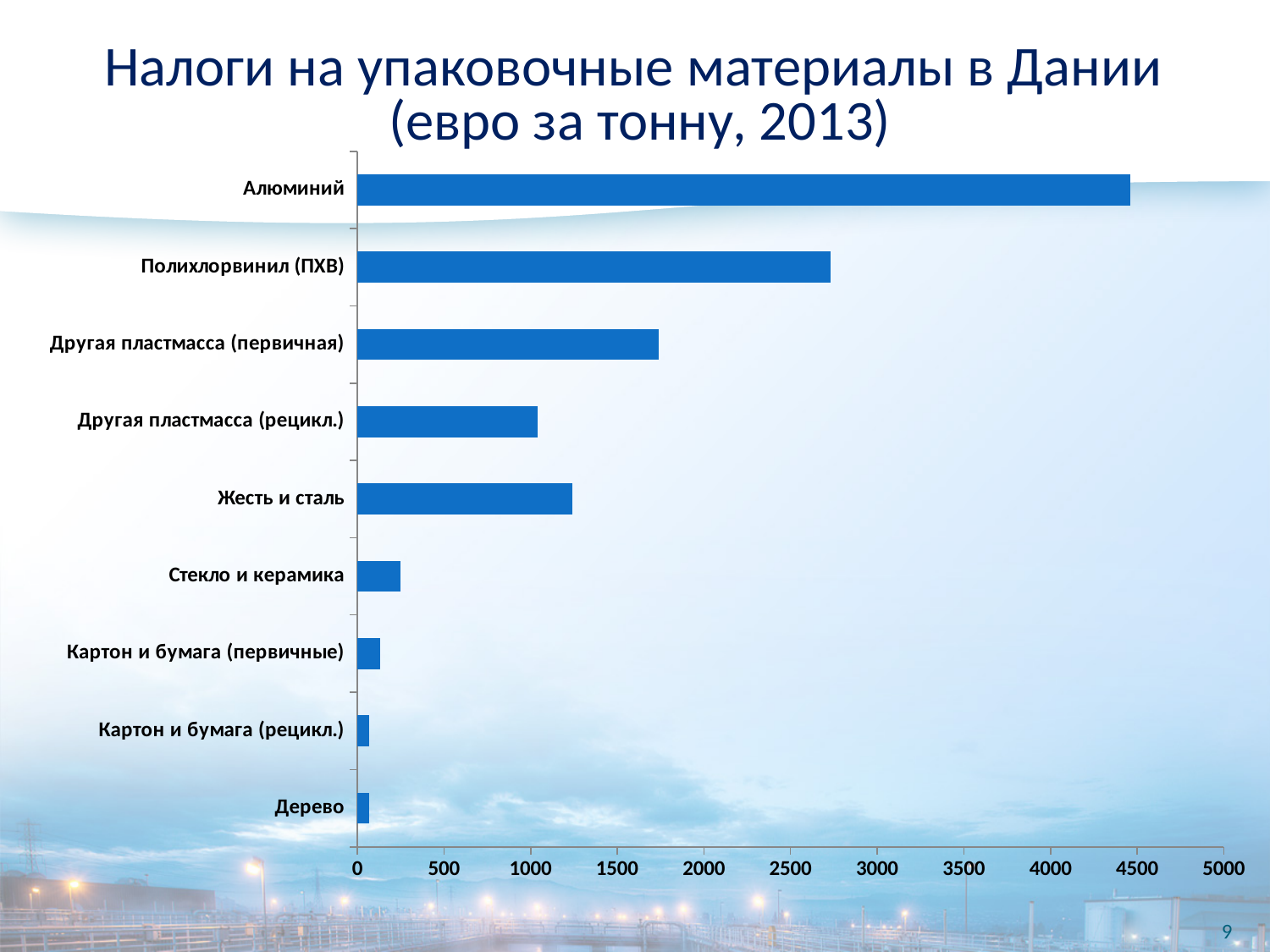
Which packaging material has the highest tax in the chart? Алюминий What kind of chart is shown on the slide? bar chart Is the value for Жесть и сталь greater or less than 1000? greater Which has a higher value: Жесть и сталь or Другая пластмасса (рецикл.)? Жесть и сталь Which has a higher value: Полихлорвинил (ПХВ) or Другая пластмасса (первичная)? Полихлорвинил (ПХВ) Is the value for Другая пластмасса (первичная) greater or less than 1500? greater Is the value for Картон и бумага (первичные) greater or less than 500? less What is the maximum value shown on the horizontal axis of the chart? 5000 How many packaging material categories are shown in the chart? 9